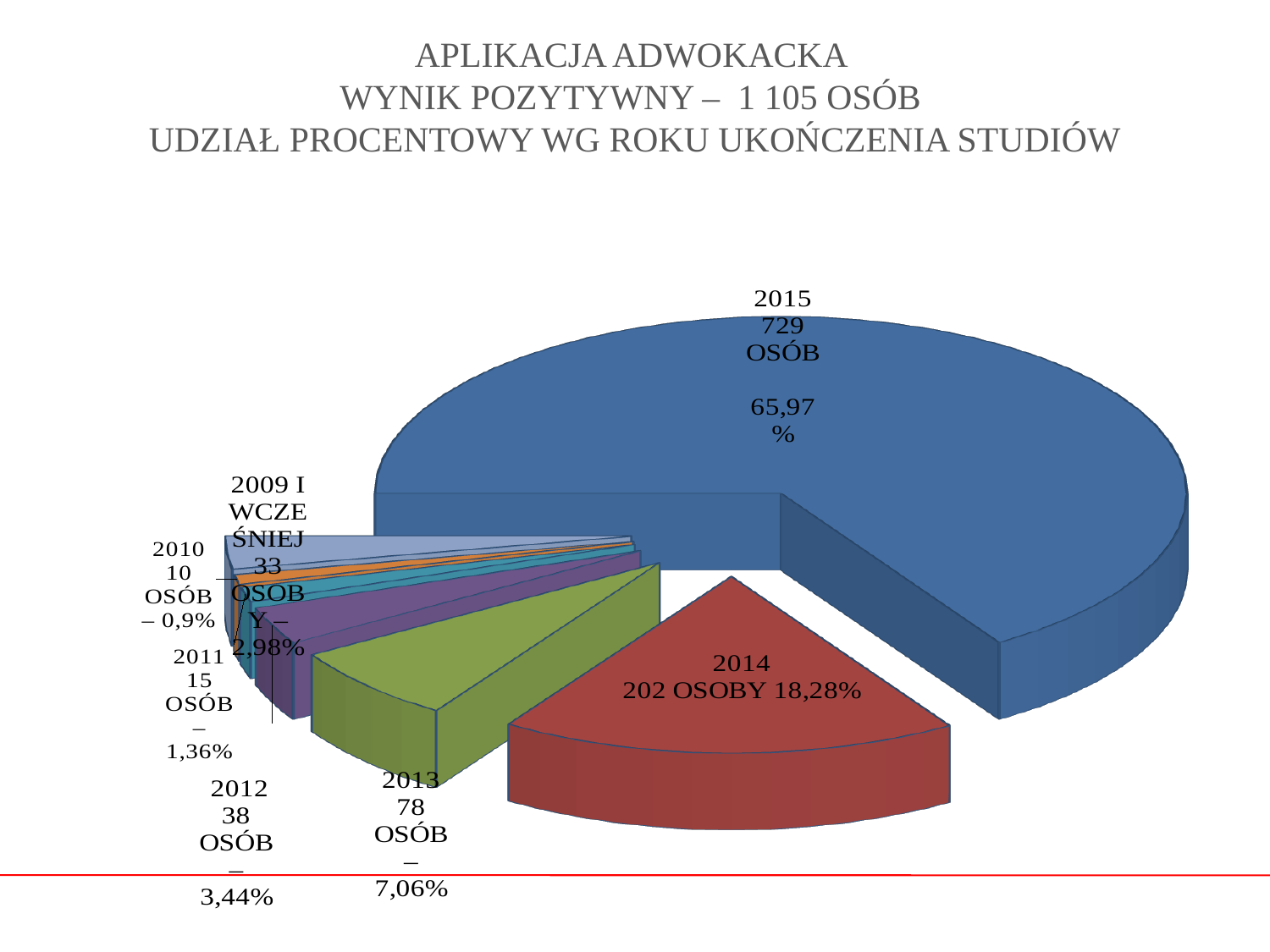
How many categories (slices) does the pie chart have? 7 Which year has the largest slice of the pie? 2015 How many people are shown for the category '2009 i wcześniej'? 33 How many people are shown for 2013? 78 How many more people are shown for 2014 than for 2013? 124 What percentage share is shown for 2010? 0,9% What kind of chart is shown on the slide? pie chart What percentage share is shown for 2012? 3,44% What percentage share is shown for 2014? 18,28% Which has more people, 2012 or 2011? 2012 How many people (osób) are shown for 2015? 729 Which category has the smallest slice of the pie? 2010